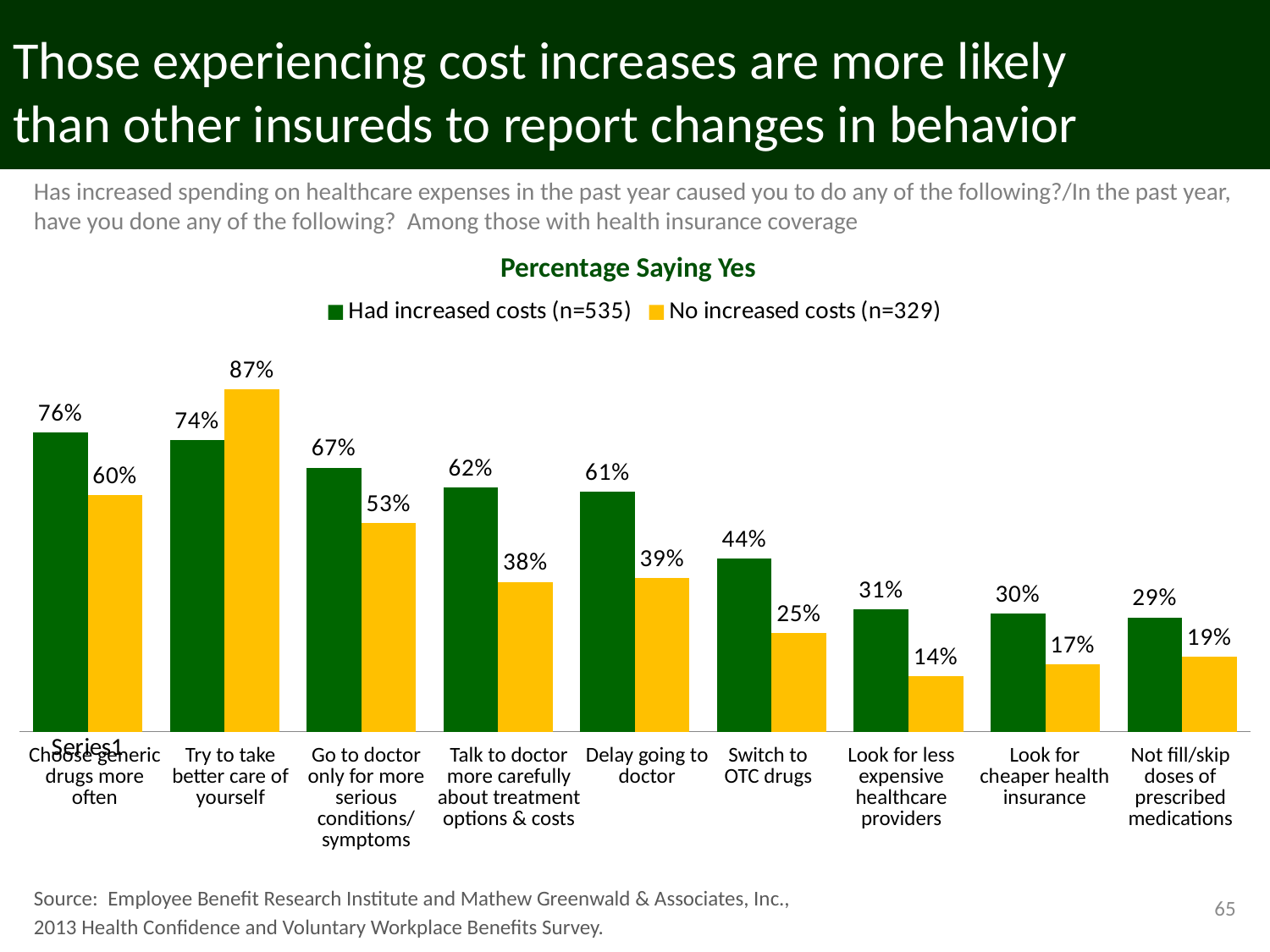
How many behavior categories are shown on the x axis? 9 What percentage of those with no increased costs said they look for less expensive healthcare providers? 14% What kind of chart is shown on the slide? Bar chart What is the title of the chart? Percentage Saying Yes Which category has the lowest value for the 'Had increased costs' series? Not fill/skip doses of prescribed medications For 'Switch to OTC drugs', which series has the larger value? Had increased costs (n=535) Do the 'Had increased costs' values generally rise or fall from left to right across the categories? Fall What is the difference between the 'Had increased costs' and 'No increased costs' values for 'Delay going to doctor'? 22 percentage points Which category has the highest value for the 'No increased costs' series? Try to take better care of yourself What percentage of those who had increased costs said they choose generic drugs more often? 76% What percentage of those with no increased costs said they try to take better care of themselves? 87% How many series does the legend list? 2